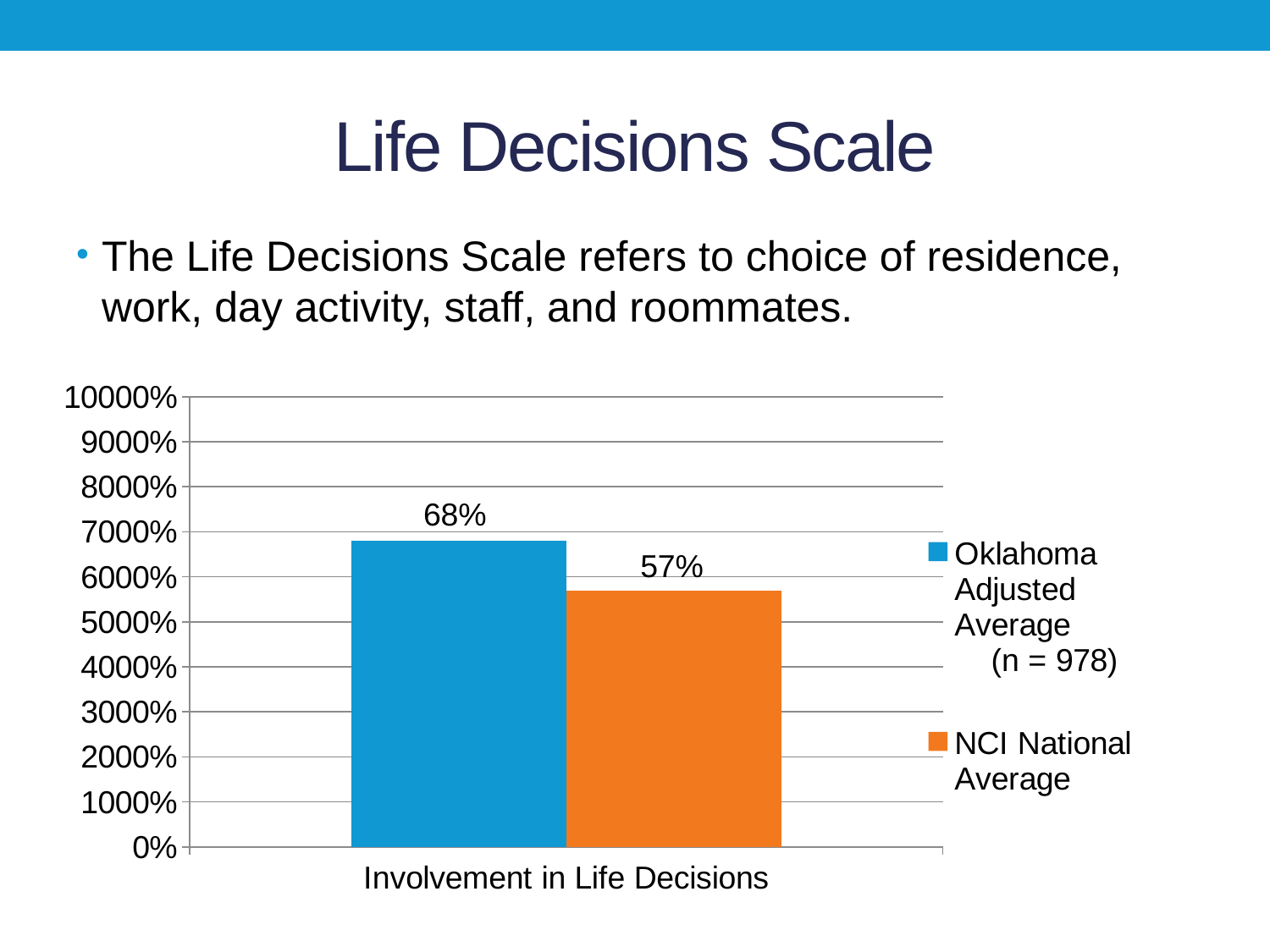
How many series does the legend list? 2 Which series has the higher value for Involvement in Life Decisions? Oklahoma Adjusted Average (n = 978) How many categories are shown on the x axis? 1 What is the difference between the Oklahoma Adjusted Average and the NCI National Average values? 11% What is the value for NCI National Average for Involvement in Life Decisions? 57% What kind of chart is shown on the slide? bar chart Is the Oklahoma Adjusted Average value larger or smaller than the NCI National Average value? larger What is the value for Oklahoma Adjusted Average (n = 978) for Involvement in Life Decisions? 68% Which series has the lower value for Involvement in Life Decisions? NCI National Average What colour is the bar for NCI National Average? orange What is the category label on the x axis? Involvement in Life Decisions